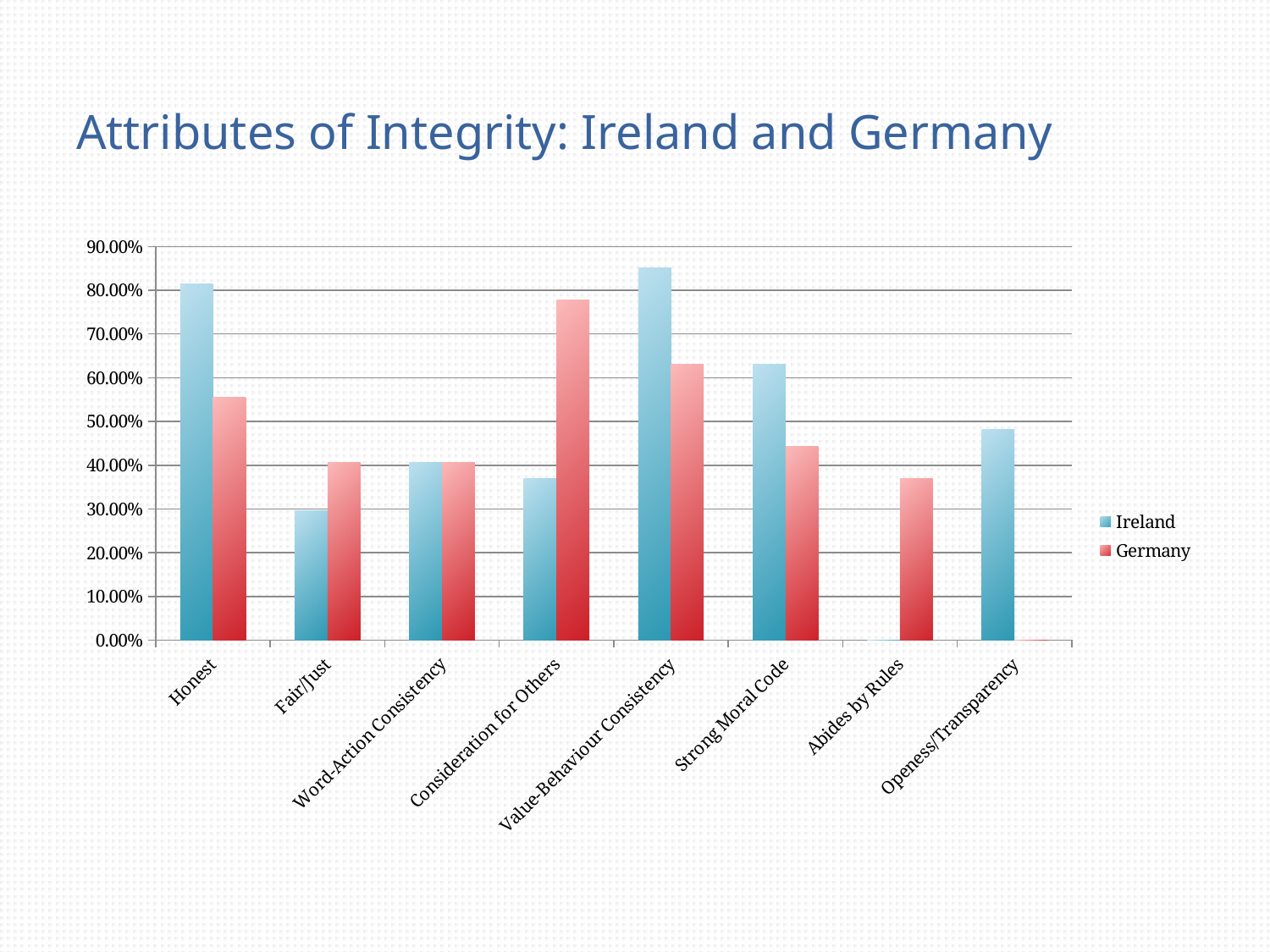
For which attribute is the Ireland value highest? Value-Behaviour Consistency How many attribute categories are shown on the x axis? 8 For the Honest attribute, which is larger: Ireland or Germany? Ireland Is the Ireland value for Honest greater or less than 70.00%? greater Which colour represents Germany in the legend? Red How many series does the legend list? 2 For Fair/Just, which is larger: Ireland or Germany? Germany For Consideration for Others, which is larger: Ireland or Germany? Germany Is the Germany value for Fair/Just greater or less than 50.00%? less For which attribute is the Germany value highest? Consideration for Others Is the Germany value for Strong Moral Code greater or less than 60.00%? less What kind of chart is shown on the slide? Bar chart